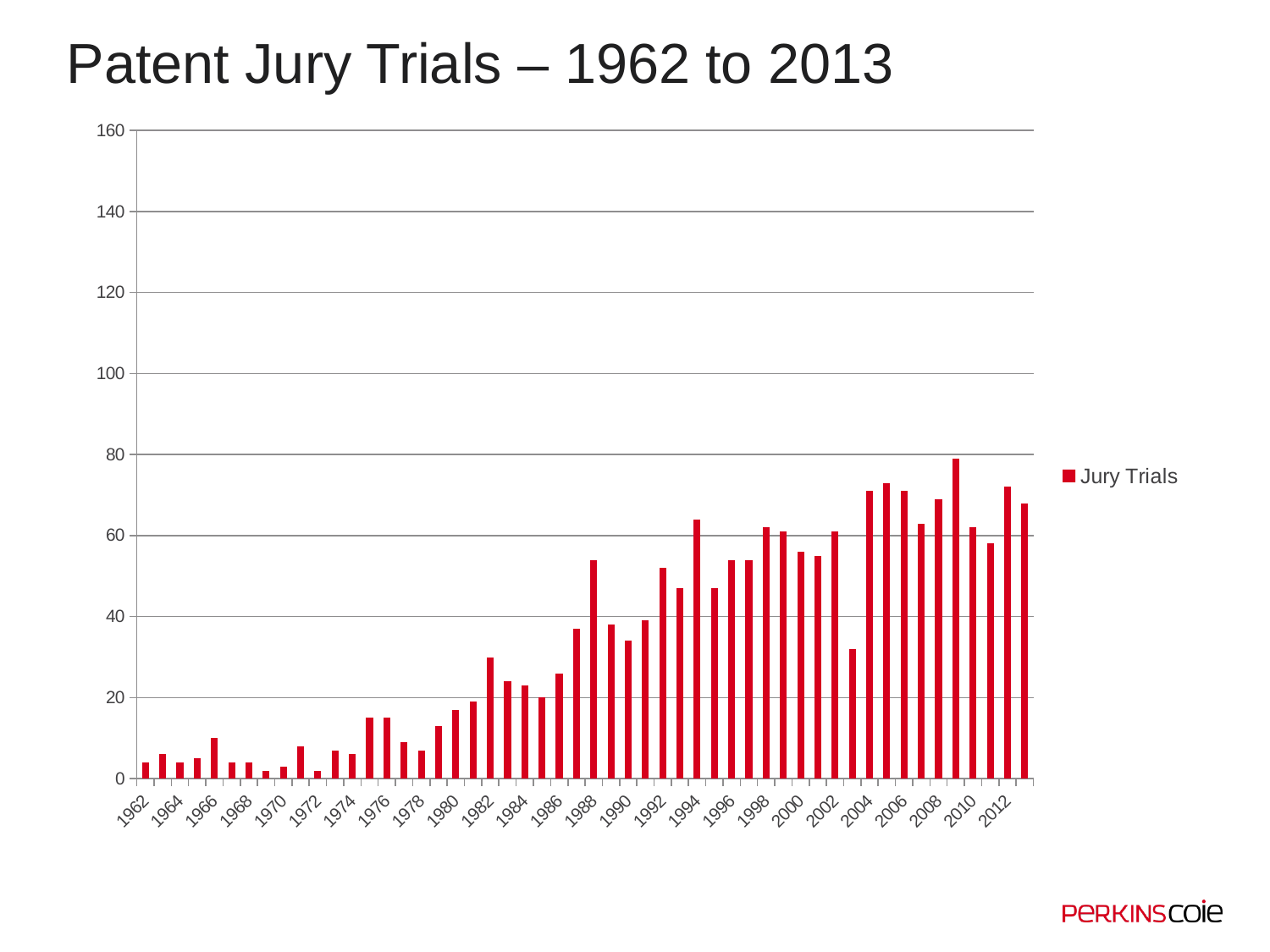
Is the value for 1988 greater or less than 40? greater Overall, do the number of jury trials rise or fall from 1962 to 2013? rise Is the value for 2003 greater or less than 40? less Which year has more jury trials, 2003 or 2005? 2005 Which year has more jury trials, 1988 or 1990? 1988 What is the name of the series shown in the legend? Jury Trials What kind of chart is shown on the slide? bar chart Is the value for 1962 greater or less than 20? less Which year has the highest number of jury trials? 2009 How many series does the legend list? 1